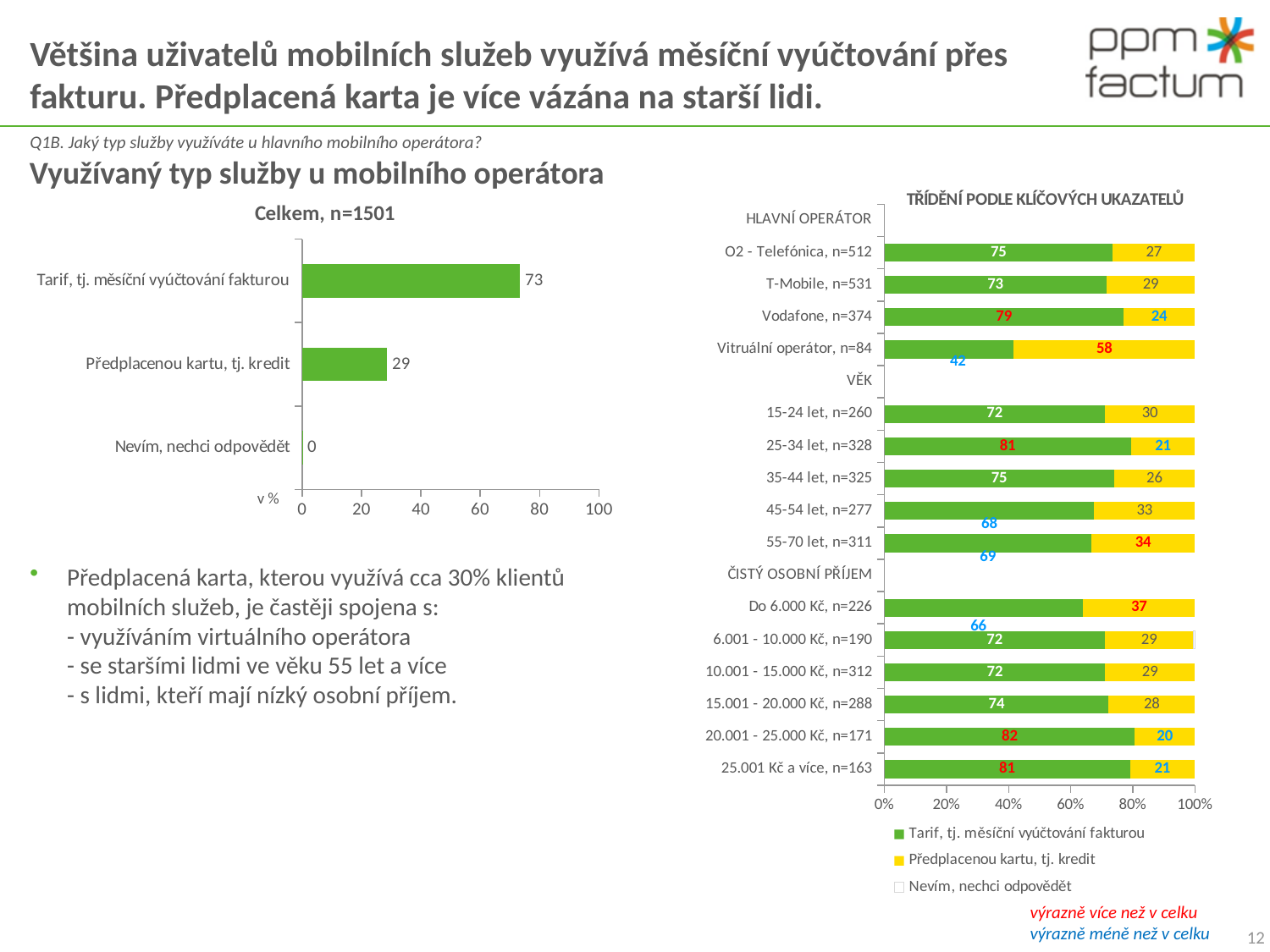
In the "Celkem, n=1501" chart, what is the value for "Předplacenou kartu, tj. kredit"? 29 In the "Celkem, n=1501" chart, how many categories are shown? 3 In the "TŘÍDĚNÍ PODLE KLÍČOVÝCH UKAZATELŮ" chart, is the "Předplacenou kartu, tj. kredit" value larger for "55-70 let, n=311" or for "25-34 let, n=328"? 55-70 let, n=311 What kind of chart is the "Celkem, n=1501" chart? bar chart In the "TŘÍDĚNÍ PODLE KLÍČOVÝCH UKAZATELŮ" chart, what is the value of "Předplacenou kartu, tj. kredit" for "Vitruální operátor, n=84"? 58 In the "TŘÍDĚNÍ PODLE KLÍČOVÝCH UKAZATELŮ" chart, what is the value of "Tarif, tj. měsíční vyúčtování fakturou" for "Vodafone, n=374"? 79 In the "TŘÍDĚNÍ PODLE KLÍČOVÝCH UKAZATELŮ" chart, what is the value of "Tarif, tj. měsíční vyúčtování fakturou" for "20.001 - 25.000 Kč, n=171"? 82 In the "Celkem, n=1501" chart, what is the difference between the values for "Tarif, tj. měsíční vyúčtování fakturou" and "Předplacenou kartu, tj. kredit"? 44 In the "Celkem, n=1501" chart, what is the value for "Tarif, tj. měsíční vyúčtování fakturou"? 73 How many series does the legend of the "TŘÍDĚNÍ PODLE KLÍČOVÝCH UKAZATELŮ" chart list? 3 In the "TŘÍDĚNÍ PODLE KLÍČOVÝCH UKAZATELŮ" chart, which age group has the highest value for "Tarif, tj. měsíční vyúčtování fakturou"? 25-34 let, n=328 In the "Celkem, n=1501" chart, which category has the highest value? Tarif, tj. měsíční vyúčtování fakturou